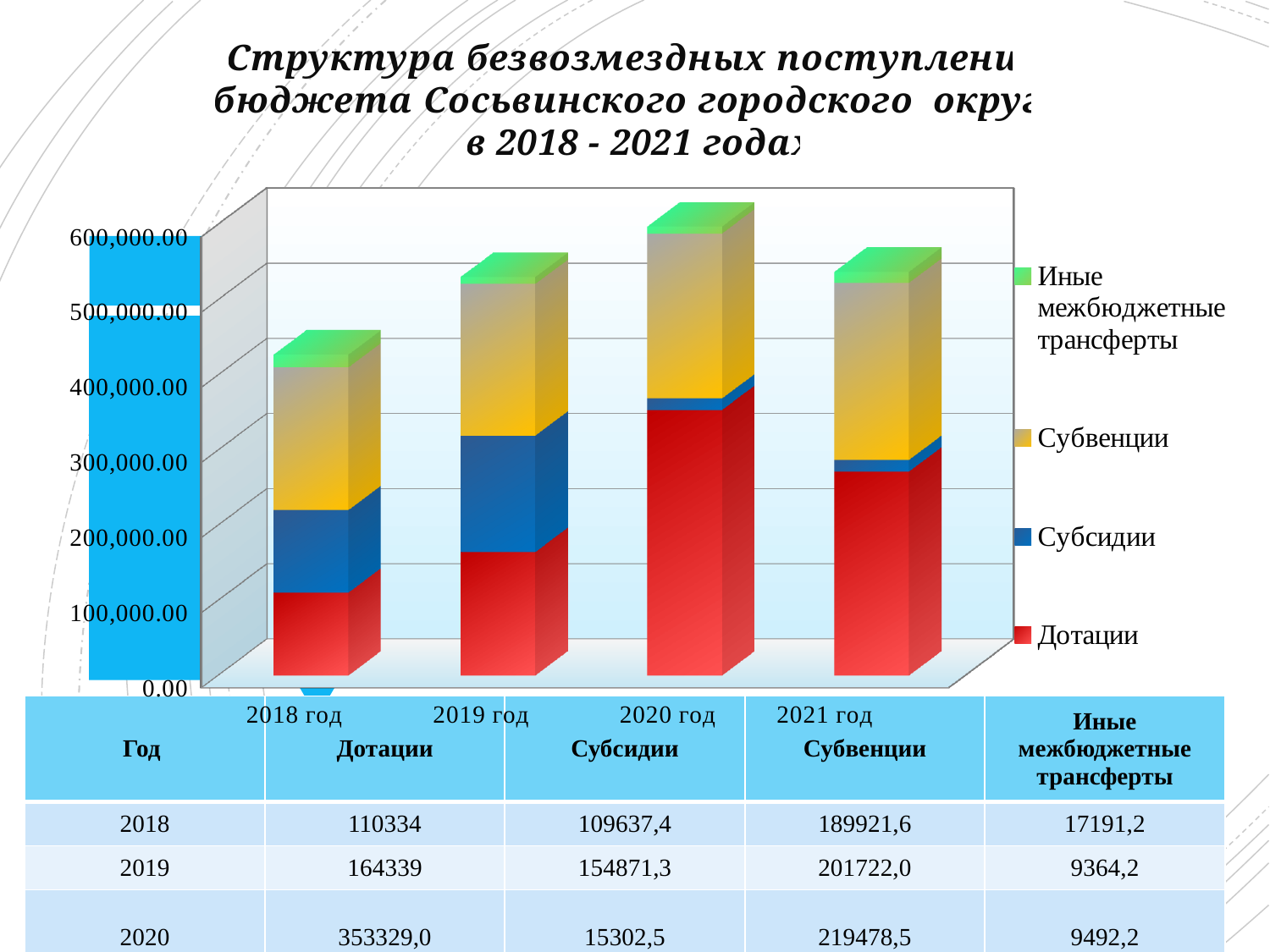
How many years (categories) are shown on the x axis of the chart? 4 Is the total height of the 2021 stacked bar greater or less than 500,000.00? greater What is the total of the stacked bar for 2018? 427084,2 What is the value of Субвенции for 2020? 219478,5 Which is larger: Субсидии in 2019 or Субсидии in 2020? Субсидии in 2019 How many series does the chart legend list? 4 Which year has the tallest stacked bar in the chart? 2020 год What is the difference between Дотации in 2020 and Дотации in 2019? 188990,0 What kind of chart is shown on the slide? stacked bar chart What is the value of Иные межбюджетные трансферты for 2019? 9364,2 Which year has the shortest stacked bar in the chart? 2018 год What is the value of Дотации for 2018? 110334